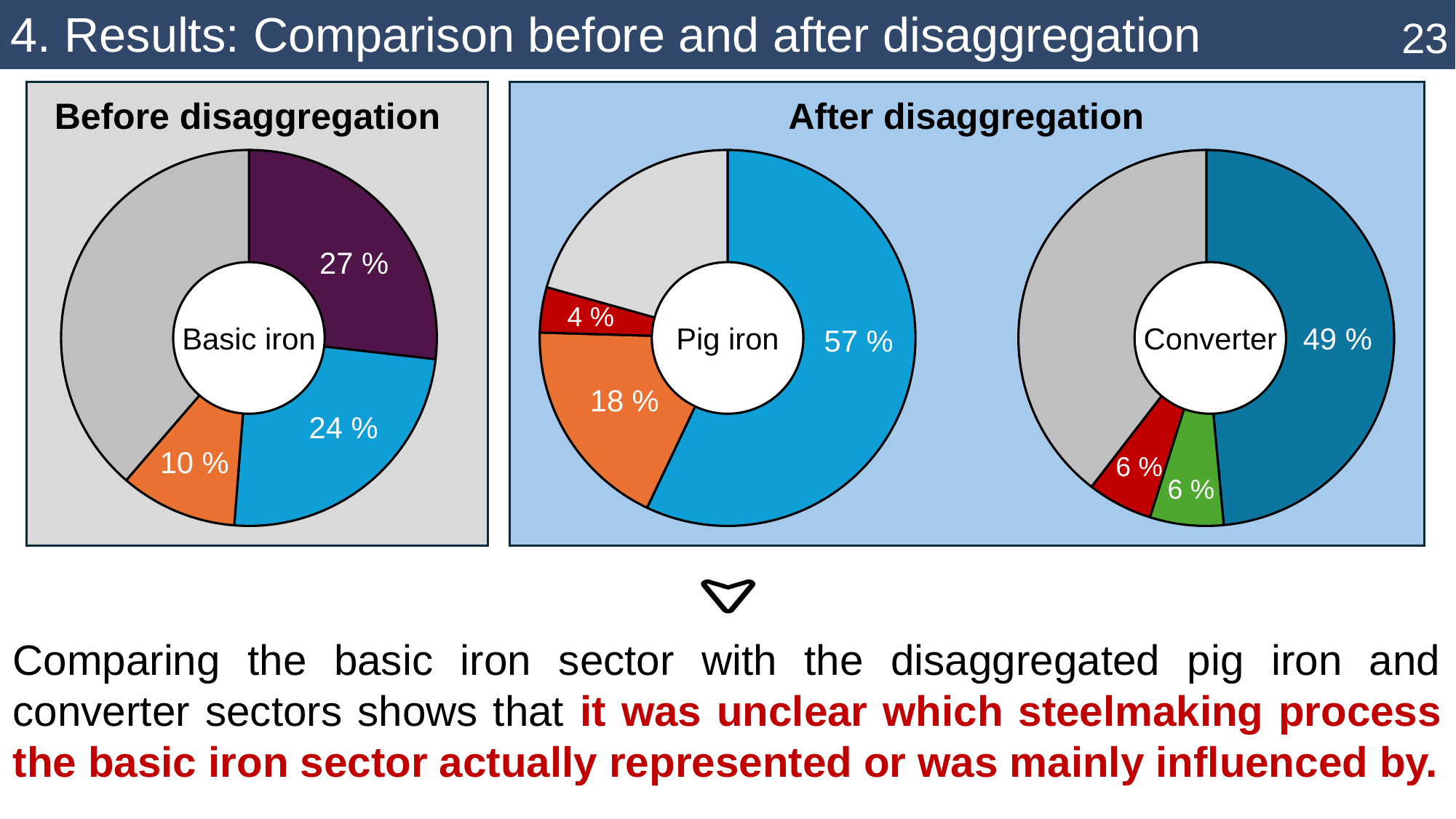
In the Basic iron chart, what percentage is shown on the dark purple slice? 27 % In the Basic iron chart, which is larger: the purple slice or the orange slice? The purple slice (27 %) What is the title of the panel containing the Pig iron and Converter charts? After disaggregation In the Basic iron chart, what percentage is shown on the orange slice? 10 % How many slices does the Converter chart have? 4 In the Pig iron chart, what is the difference between the light blue slice (57 %) and the orange slice (18 %)? 39 % In the Pig iron chart, what percentage is shown on the red slice? 4 % What kind of chart is used for the Basic iron chart under "Before disaggregation"? Pie chart (donut) In the Converter chart, what percentage is shown on the dark teal slice? 49 % In the Basic iron chart, what percentage is shown on the light blue slice? 24 % In the Pig iron chart, what percentage is shown on the large light blue slice? 57 % In the Converter chart, what is the combined share of the red and green slices? 12 %